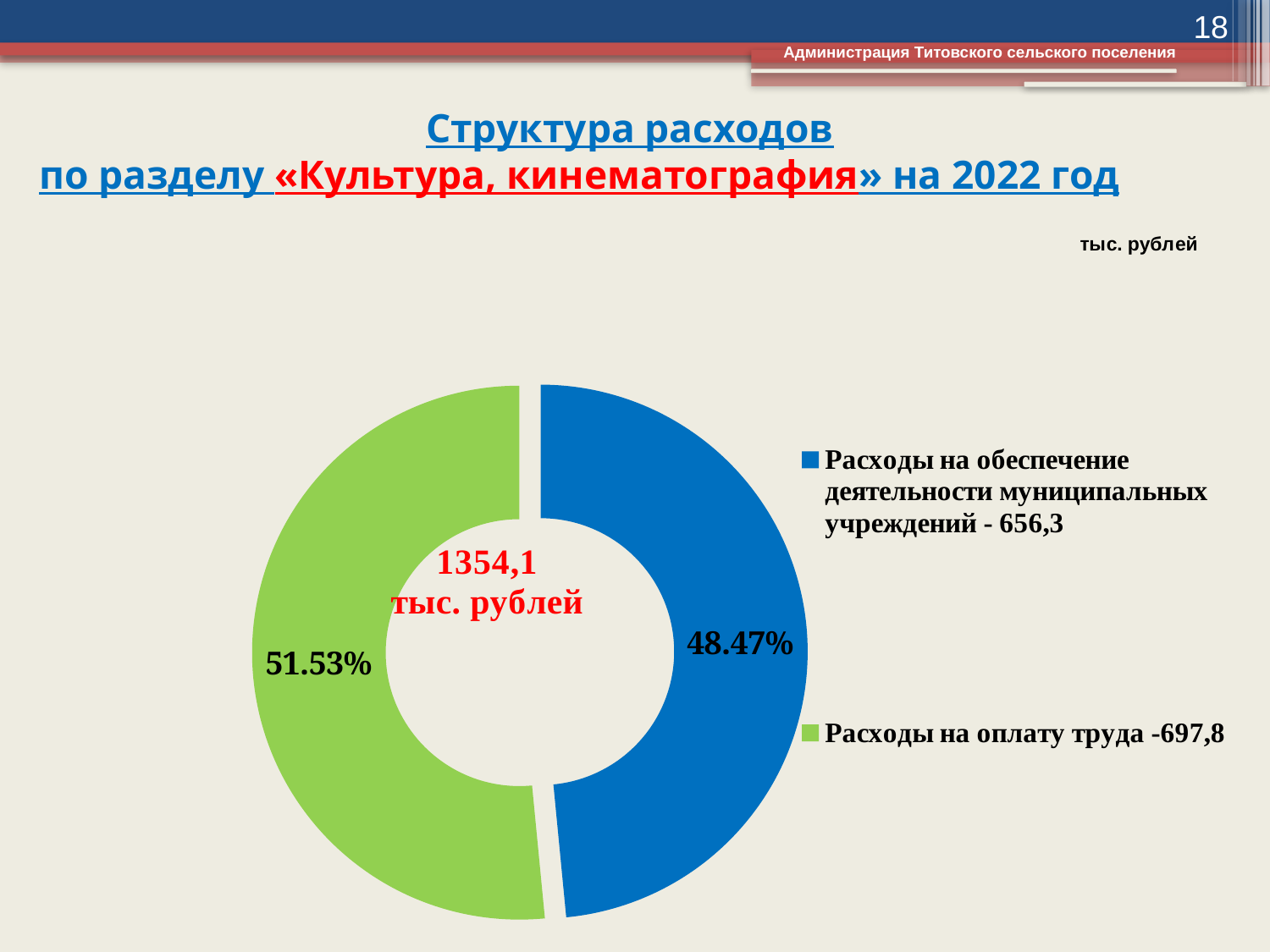
Which category has the largest share of the chart? Расходы на оплату труда What is the difference in percentage points between the two slices of the chart? 3.06% What colour is the slice for "Расходы на оплату труда"? Green Which is larger: the share for "Расходы на оплату труда" or the share for "Расходы на обеспечение деятельности муниципальных учреждений"? Расходы на оплату труда What is the value for "Расходы на оплату труда" according to the legend? 697,8 Which category has the smallest share of the chart? Расходы на обеспечение деятельности муниципальных учреждений What is the value for "Расходы на обеспечение деятельности муниципальных учреждений" according to the legend? 656,3 How many categories does the chart show? 2 What kind of chart is shown on the slide? Doughnut (pie) chart What total is printed in the centre of the chart? 1354,1 тыс. рублей What share of the chart does "Расходы на обеспечение деятельности муниципальных учреждений" take? 48.47% What share of the chart does "Расходы на оплату труда" take? 51.53%